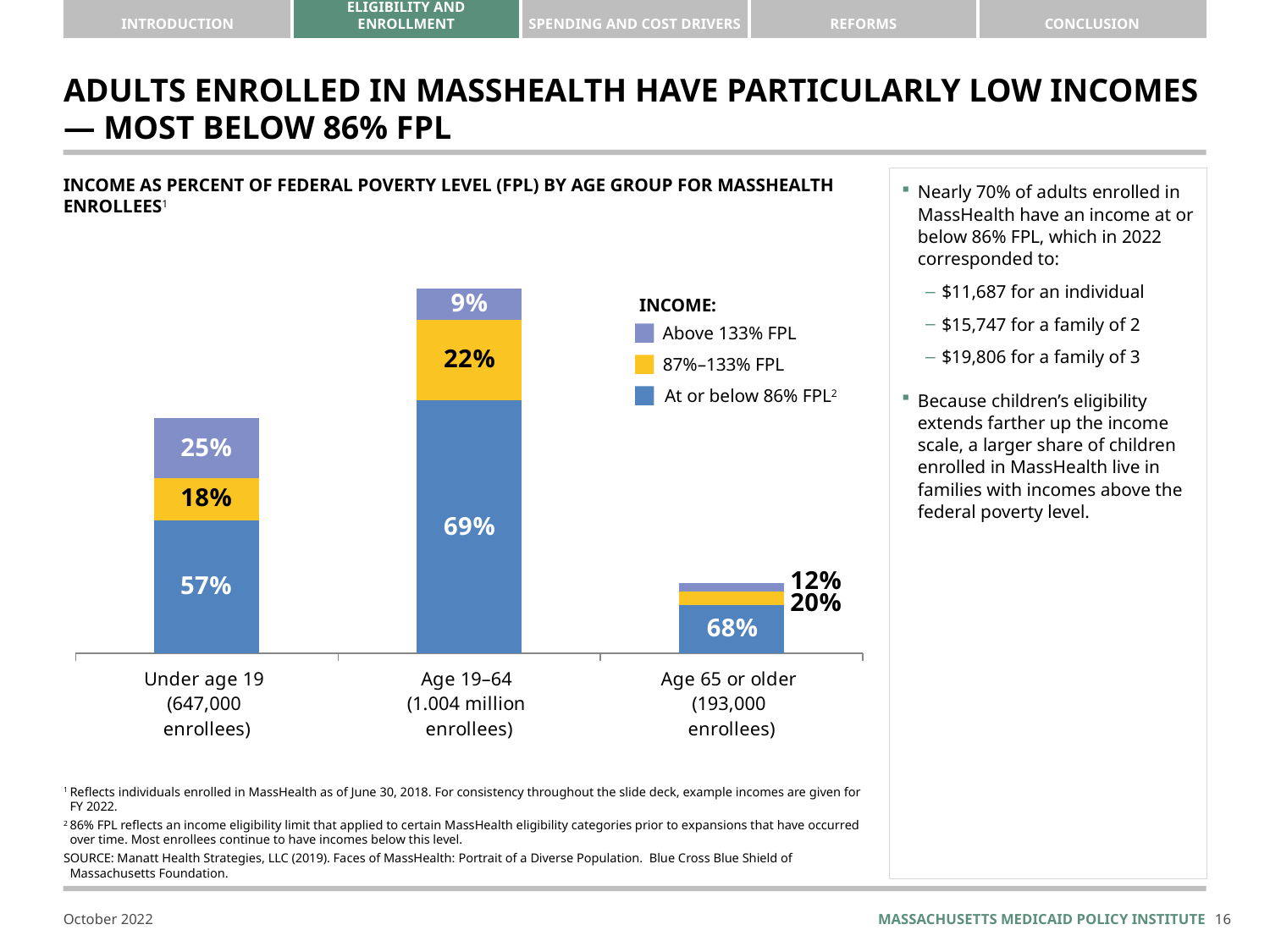
How many income categories does the legend list? 3 Which age group has the highest share of enrollees at or below 86% FPL? Age 19–64 What is the total of the three segments for the Under age 19 bar? 100% What type of chart is used on this slide? Stacked bar chart What percentage of MassHealth enrollees under age 19 have income at or below 86% FPL? 57% Is the share of enrollees above 133% FPL larger for Under age 19 or for Age 65 or older? Under age 19 How many enrollees are in the Age 19–64 group according to the axis label? 1.004 million enrollees What percentage of enrollees age 65 or older have income in the 87%–133% FPL range? 20% What share of enrollees aged 19–64 have income above 133% FPL? 9% How many age groups are shown in the chart? 3 What is the difference between the share of enrollees at or below 86% FPL in the Age 19–64 group and the Under age 19 group? 12 percentage points Which age group has the lowest share of enrollees above 133% FPL? Age 19–64